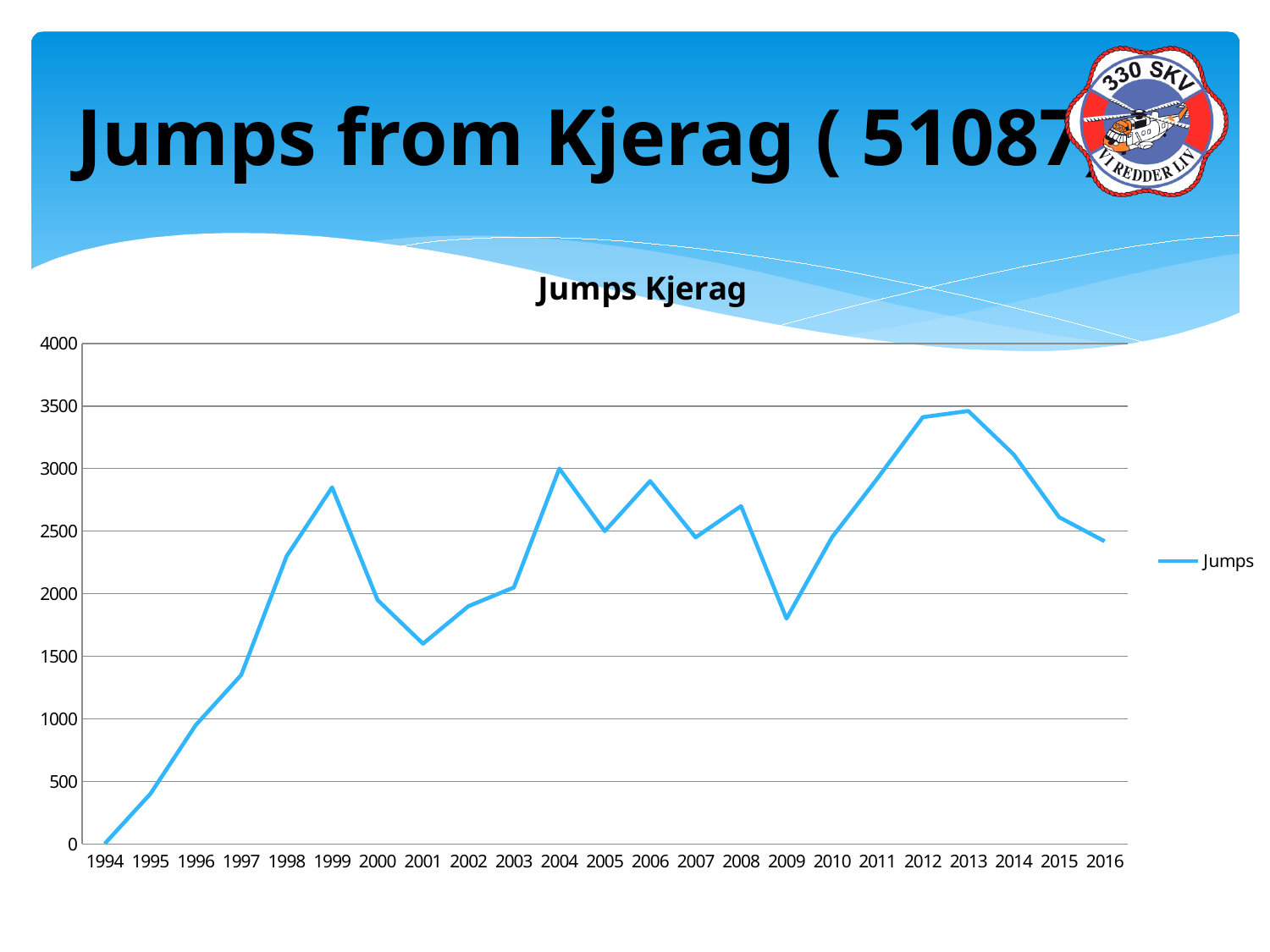
How many series does the legend list? 1 What is the title of the chart? Jumps Kjerag What is the name of the series shown in the legend? Jumps What kind of chart is shown on the slide? line chart Is the value for 1997 greater or less than 1500? less Do the values rise or fall from 1994 to 1999? rise Which is larger, the value for 1999 or the value for 2000? 1999 Is the value for 2012 greater or less than 3000? greater How many years are plotted along the x axis? 23 Is the value for 2009 greater or less than 2000? less Which year has the lowest value? 1994